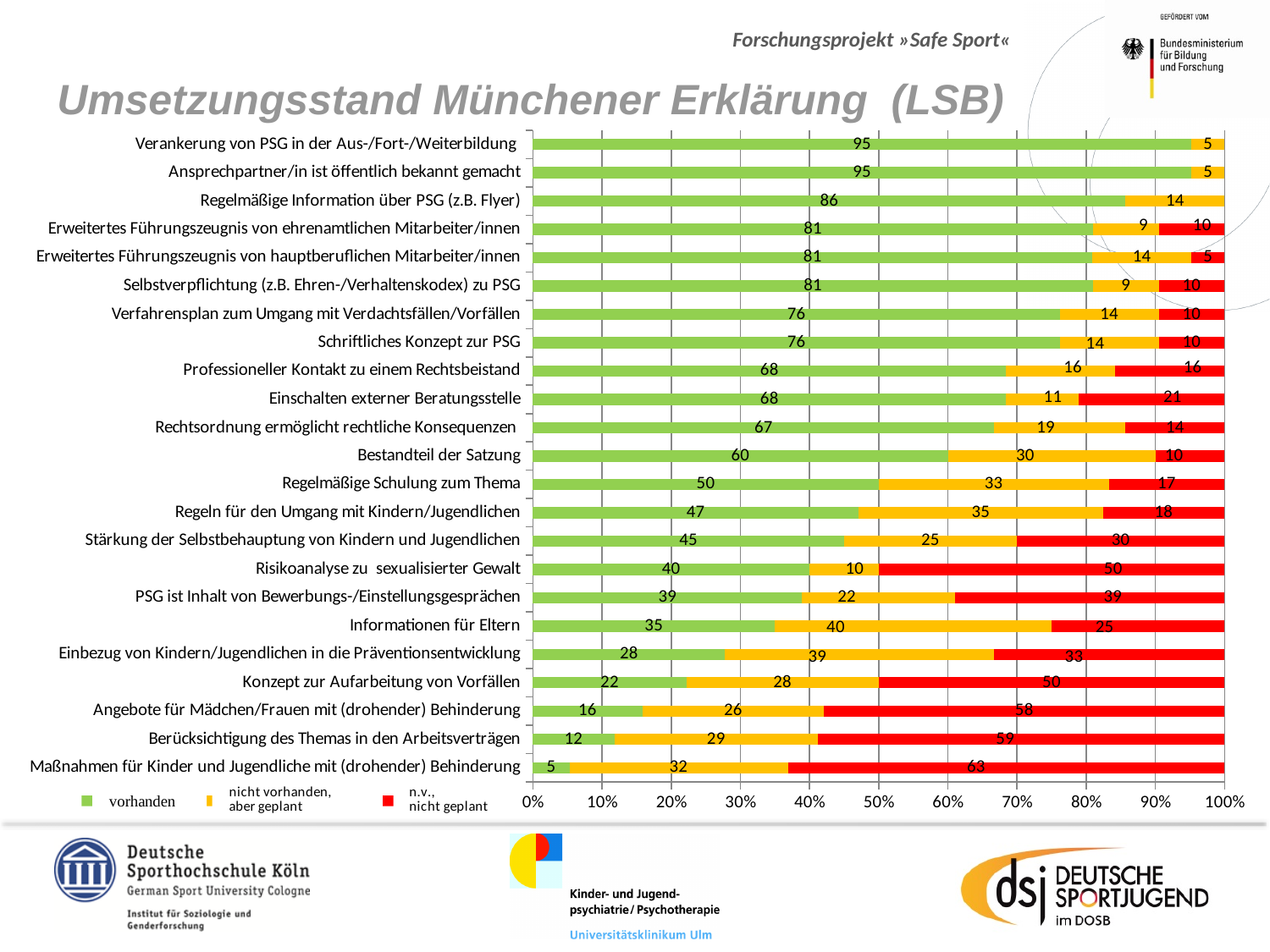
What is the difference between the 'vorhanden' values for 'Regelmäßige Schulung zum Thema' and 'Konzept zur Aufarbeitung von Vorfällen'? 28 Which category has the highest 'n.v., nicht geplant' value? Maßnahmen für Kinder und Jugendliche mit (drohender) Behinderung What is the 'vorhanden' value for 'Bestandteil der Satzung'? 60 Which category has the lowest 'vorhanden' value? Maßnahmen für Kinder und Jugendliche mit (drohender) Behinderung How many categories are plotted on the chart? 23 How many series does the legend list? 3 What is the title of the chart? Umsetzungsstand Münchener Erklärung (LSB) What kind of chart is shown on the slide? stacked bar chart What is the 'n.v., nicht geplant' value for 'Risikoanalyse zu sexualisierter Gewalt'? 50 Which has a larger 'vorhanden' value: 'Schriftliches Konzept zur PSG' or 'Einschalten externer Beratungsstelle'? Schriftliches Konzept zur PSG What is the total of the stacked bar for 'Stärkung der Selbstbehauptung von Kindern und Jugendlichen'? 100 What is the 'nicht vorhanden, aber geplant' value for 'Informationen für Eltern'? 40